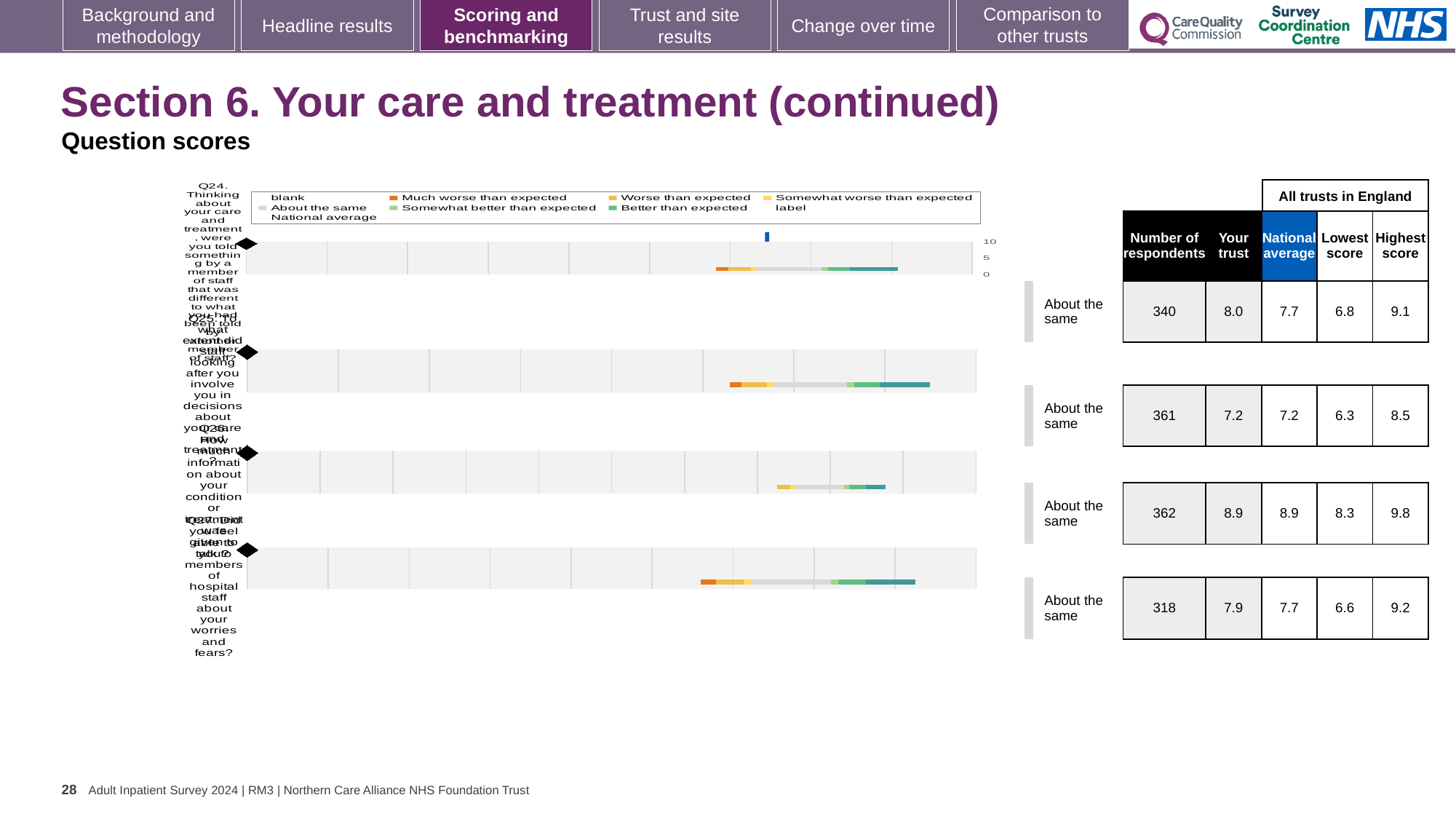
Which question on the slide has the fewest respondents? Q27 What is the 'Your trust' score for Q24 (the first question on the slide)? 8.0 How many respondents answered Q27 (the fourth question on the slide)? 318 What is the lowest score across all trusts in England for Q24? 6.8 What kind of chart is used for each question on this slide? Bar chart What is the highest score across all trusts in England for Q26 (the third question on the slide)? 9.8 What benchmark category is shown for Q25? About the same How many questions are charted on this slide? 4 What is the national average score for Q25 (the second question on the slide)? 7.2 What is the difference between the 'Your trust' score and the national average for Q24? 0.3 Which question on the slide has the highest 'Your trust' score? Q26 For Q27, which is larger: the 'Your trust' score or the national average? Your trust